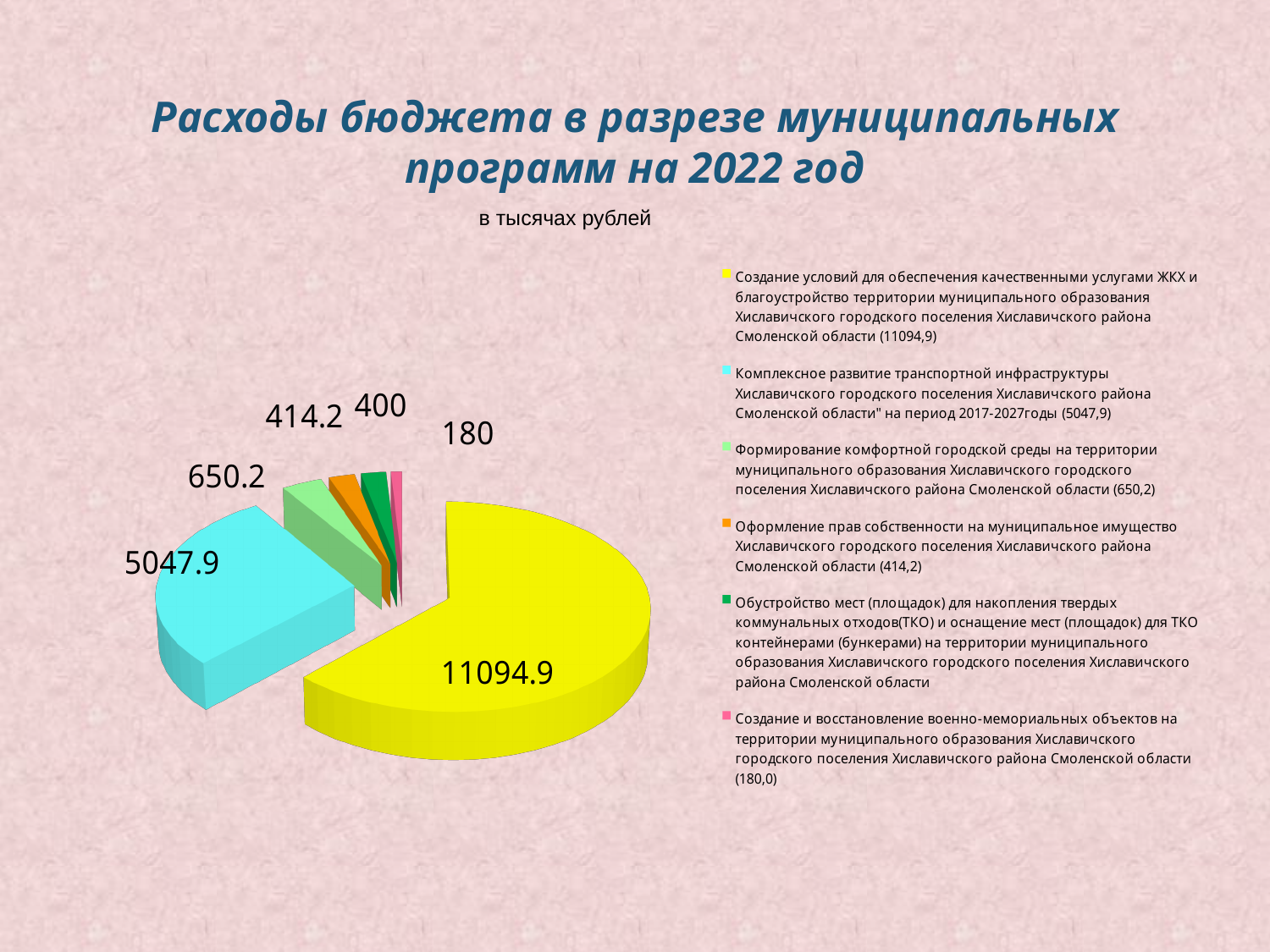
How many slices does the pie chart have? 6 What is the value of the largest slice of the pie chart? 11094.9 What is the difference between the largest slice (11094.9) and the light blue slice (5047.9)? 6047 What is the value for the program "Обустройство мест (площадок) для накопления твердых коммунальных отходов (ТКО)" (dark green slice)? 400 What is the value of the smallest slice of the pie chart? 180 Which is larger: the value for "Оформление прав собственности" (414.2) or the value for "Обустройство мест для накопления ТКО" (400)? Оформление прав собственности (414.2) What kind of chart is shown on the slide? Pie chart What is the value for the program "Комплексное развитие транспортной инфраструктуры" (light blue slice)? 5047.9 What is the value for the program "Формирование комфортной городской среды" (light green slice)? 650.2 In what units are the values on the chart given, according to the subtitle? в тысячах рублей How many entries does the legend list? 6 What is the value for the program "Оформление прав собственности на муниципальное имущество" (orange slice)? 414.2